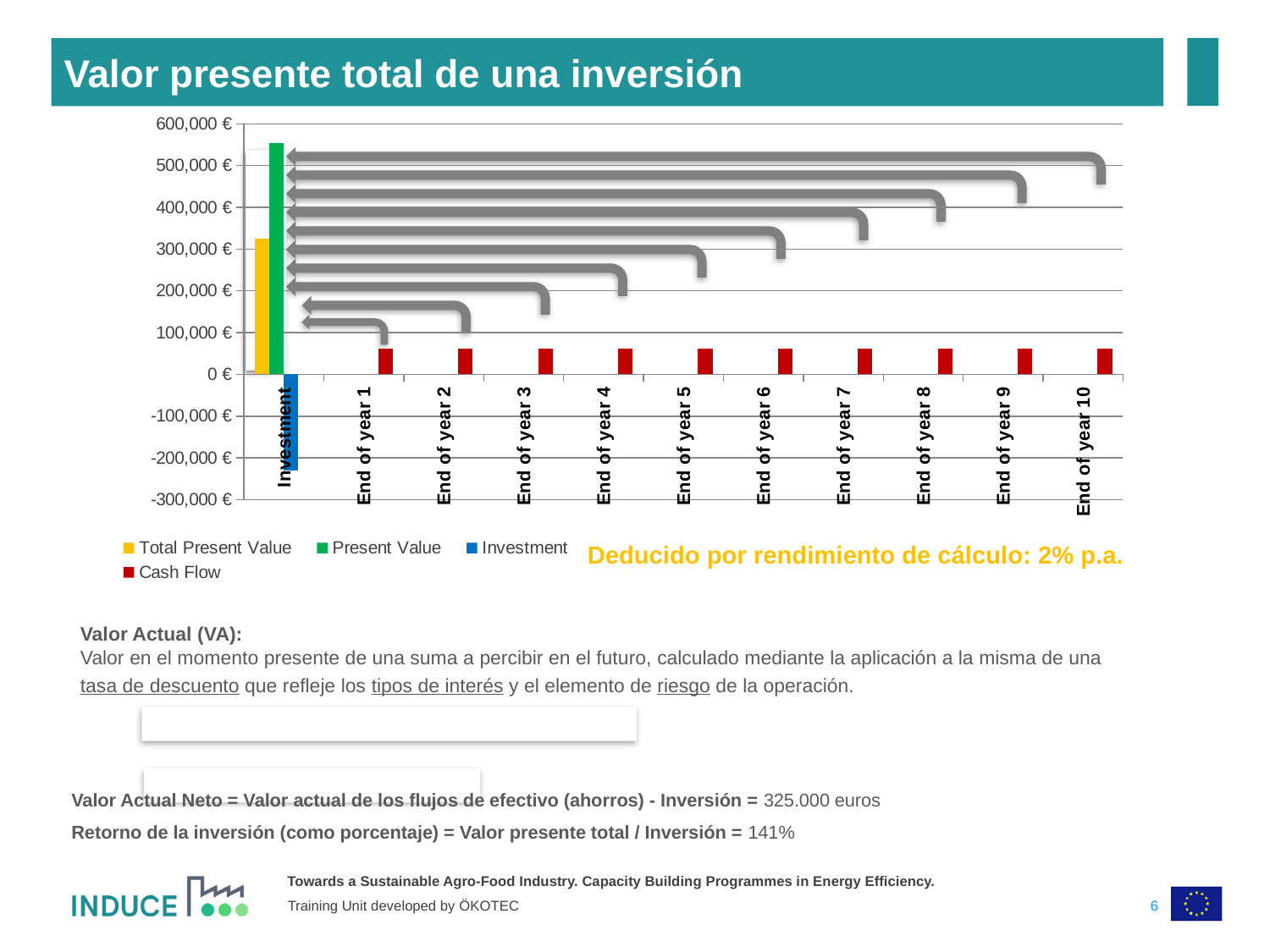
What colour represents Cash Flow in the chart legend? red Which is the only bar in the chart that extends below 0 €? Investment Is the Total Present Value bar greater or less than 200,000 €? greater Is the Investment bar greater or less than -100,000 €? less Which series has the tallest bar in the chart? Present Value How many categories are shown along the x axis of the chart? 11 Do the Cash Flow bars rise, fall, or stay roughly the same from End of year 1 to End of year 10? stay roughly the same Is the Cash Flow bar for End of year 5 greater or less than 100,000 €? less How many series does the chart legend list? 4 What kind of chart is shown on the slide? bar chart Which is larger, the Present Value bar or the Total Present Value bar? Present Value